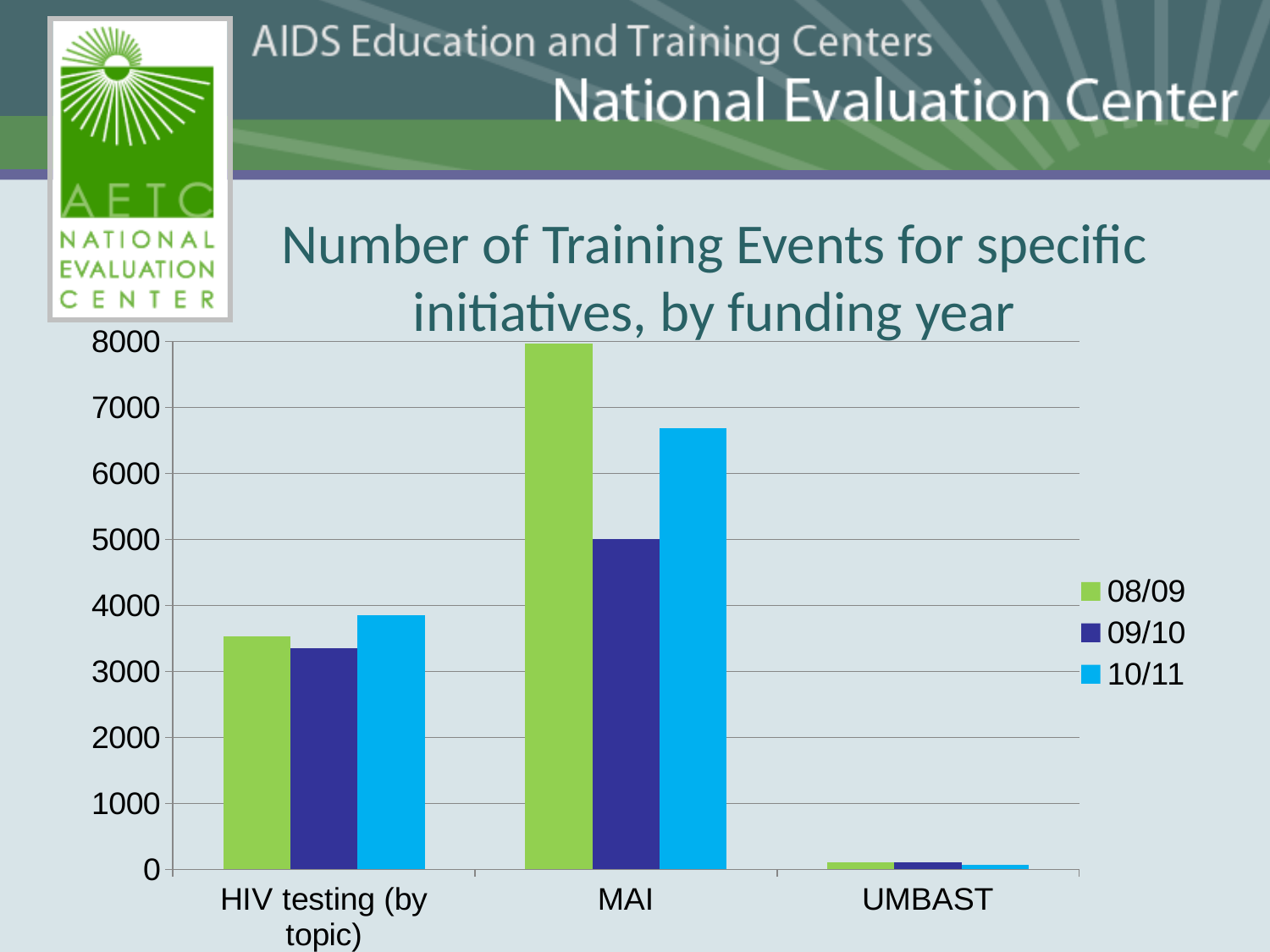
How many categories are shown on the x axis? 3 Is the value for MAI in 10/11 greater or less than 6000? greater Is the value for HIV testing (by topic) in 09/10 greater or less than 3000? greater Is the value for UMBAST in 09/10 greater or less than 1000? less How many series does the legend list? 3 Which category has the lowest number of training events for 10/11? UMBAST For MAI, which funding year has more training events, 09/10 or 10/11? 10/11 Which funding year is represented by the light blue bars in the legend? 10/11 Which category has the highest number of training events for 08/09? MAI For HIV testing (by topic), which funding year has more training events, 08/09 or 10/11? 10/11 What kind of chart is shown on the slide? bar chart